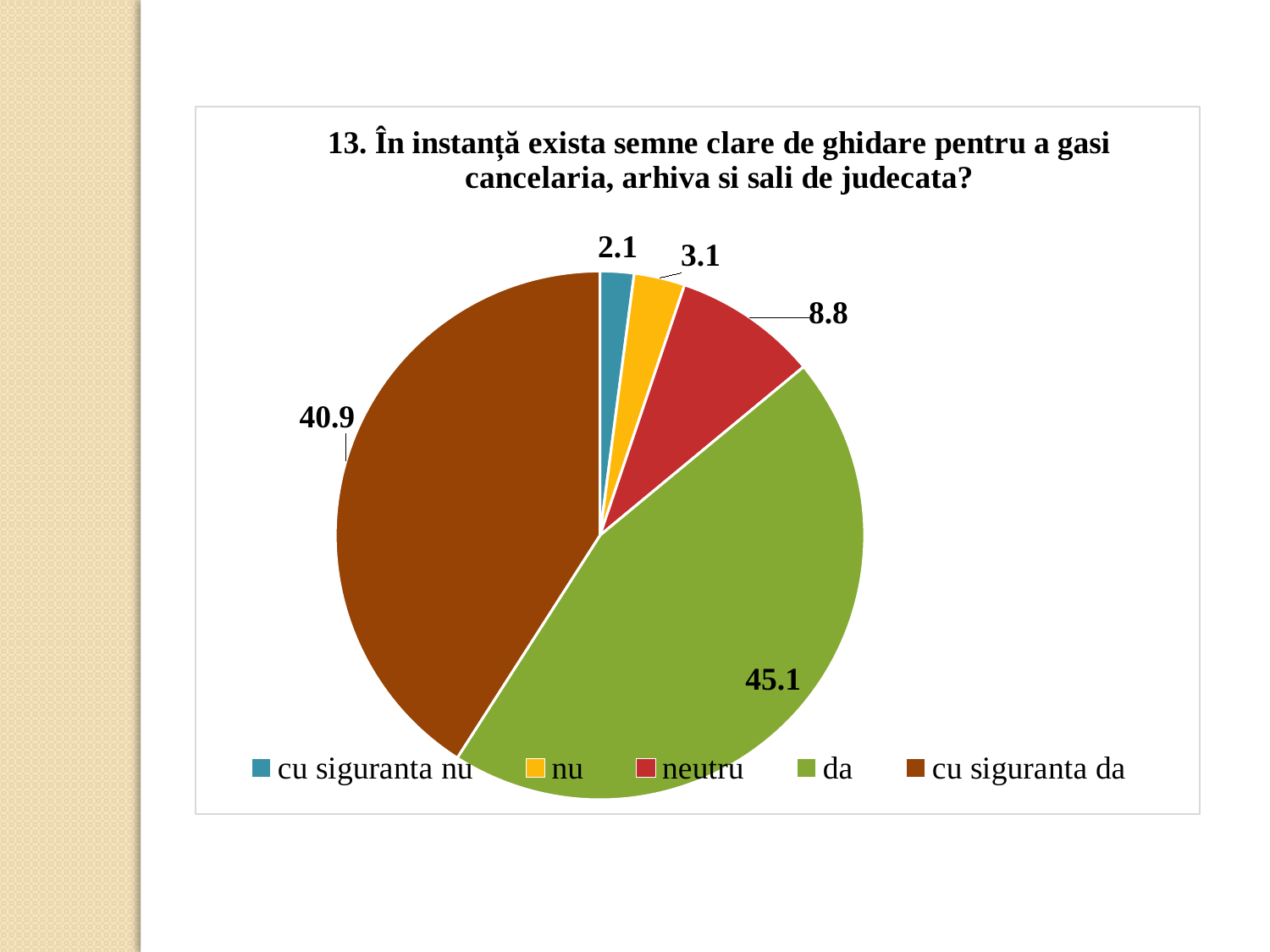
Which category has the smallest slice? cu siguranta nu What is the value for "da"? 45.1 What is the value for "nu"? 3.1 How many categories does the pie chart have? 5 Which is larger, the value for "neutru" or the value for "nu"? neutru What colour is the slice for "neutru"? red What is the difference between the values for "da" and "cu siguranta da"? 4.2 What kind of chart is shown on the slide? pie chart What is the value for "cu siguranta nu"? 2.1 What is the value for "cu siguranta da"? 40.9 Which category has the largest slice? da What is the value for "neutru"? 8.8